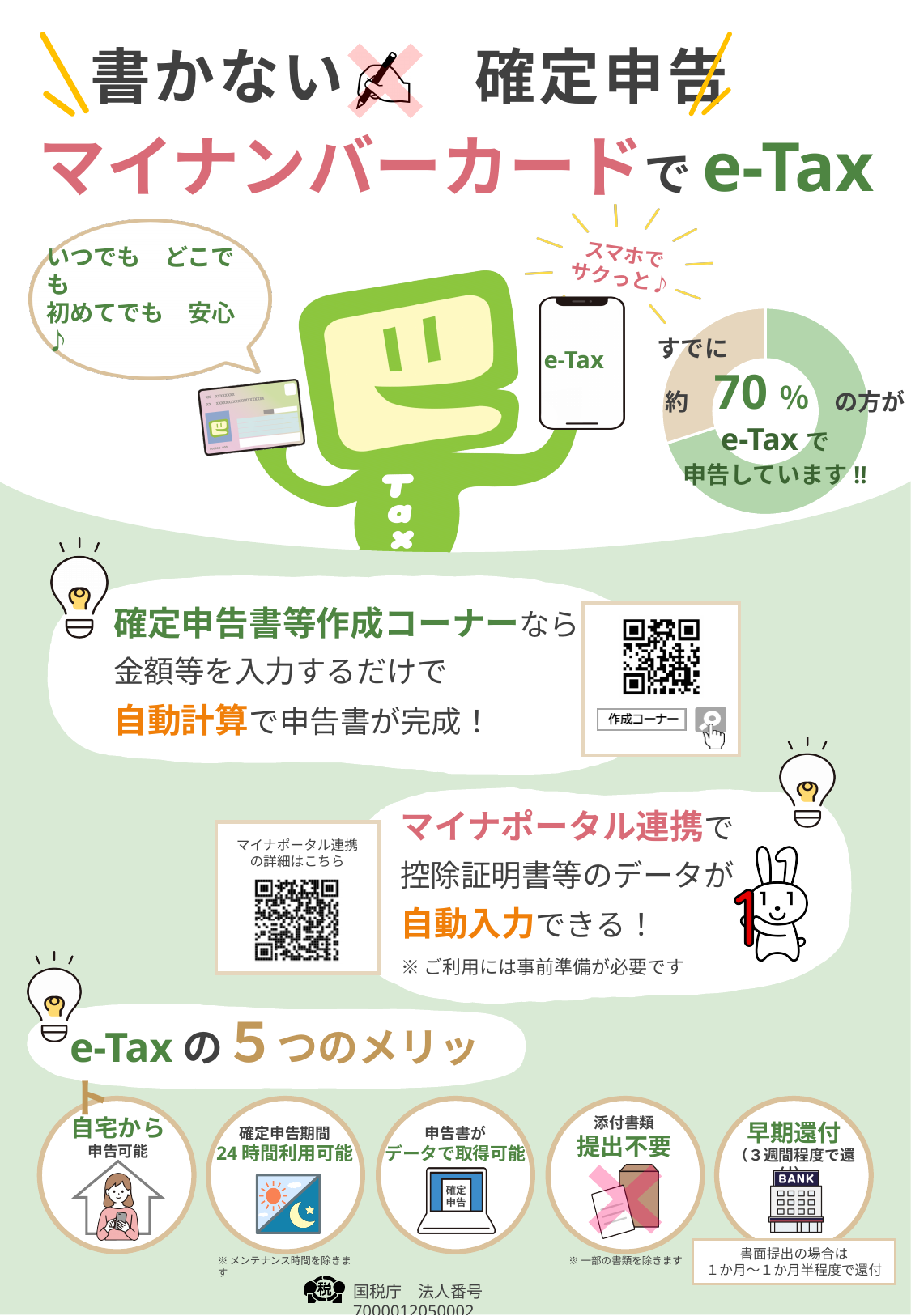
What does the donut chart illustrate? the share of people already filing via e-Tax In the donut chart, is the share of people filing via e-Tax greater or less than 50%? greater How many slices does the donut chart have? 2 What colour is the slice representing people who file via e-Tax in the donut chart? green In the donut chart, which slice is larger: the green slice (e-Tax filers) or the beige slice? the green slice (e-Tax filers) According to the donut chart, what share of people already file their tax return via e-Tax? 約70% What kind of chart is shown next to the text 'すでに約70%の方がe-Taxで申告しています!!'? pie chart (donut)